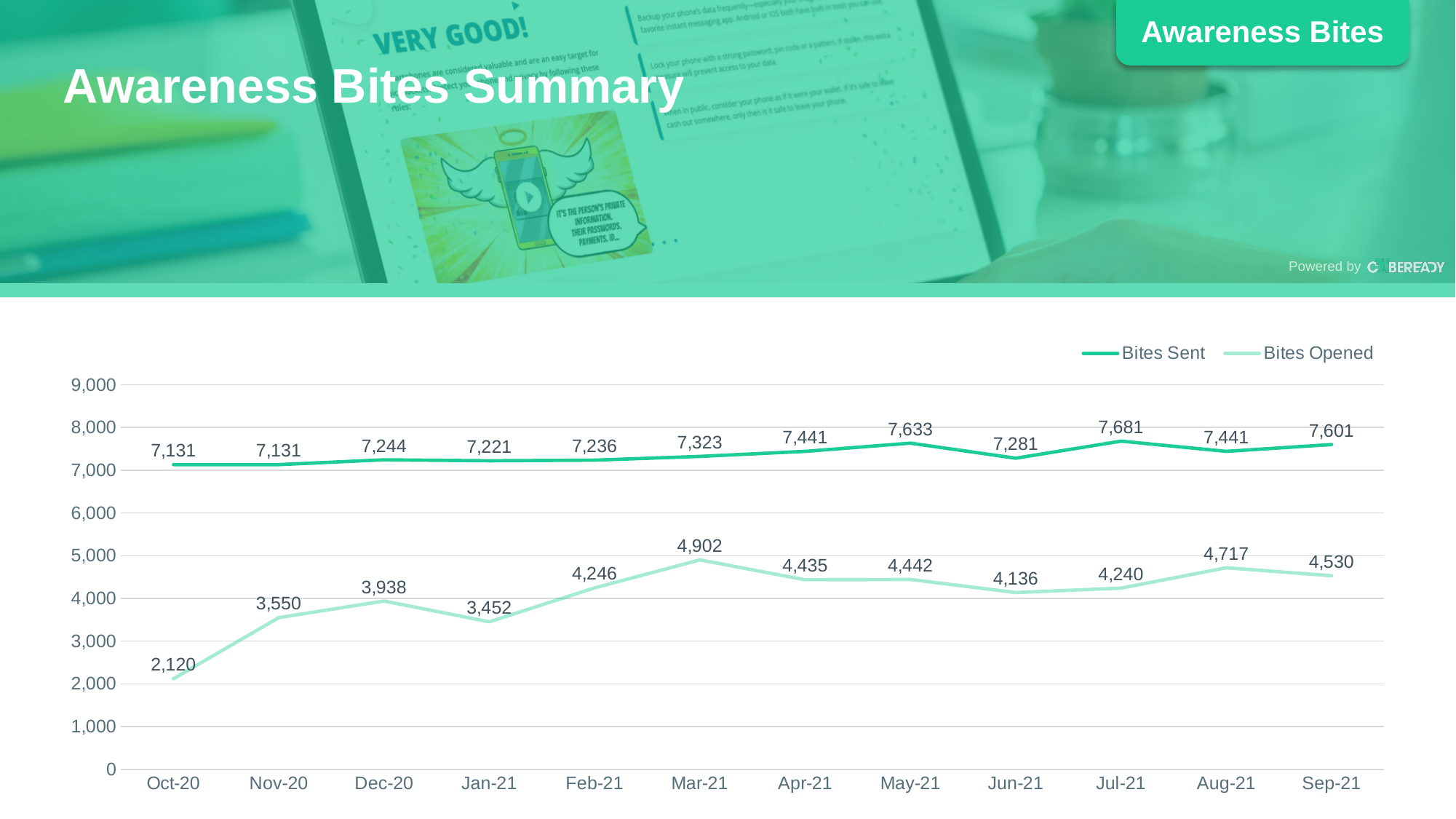
In which month is Bites Opened highest? Mar-21 What is the difference between Bites Sent and Bites Opened in Sep-21? 3,071 What type of chart is shown on the slide? Line chart What is the value of Bites Opened for Jan-21? 3,452 How many months are plotted along the x axis? 12 How many series does the legend list? 2 Does Bites Opened generally rise or fall from Oct-20 to Sep-21? Rise Which is larger, Bites Opened in Aug-21 or Bites Opened in Jun-21? Aug-21 In which month is Bites Opened lowest? Oct-20 In which month is Bites Sent highest? Jul-21 What is the value of Bites Sent for Mar-21? 7,323 Is the value of Bites Opened for Oct-20 greater or less than 3,000? less